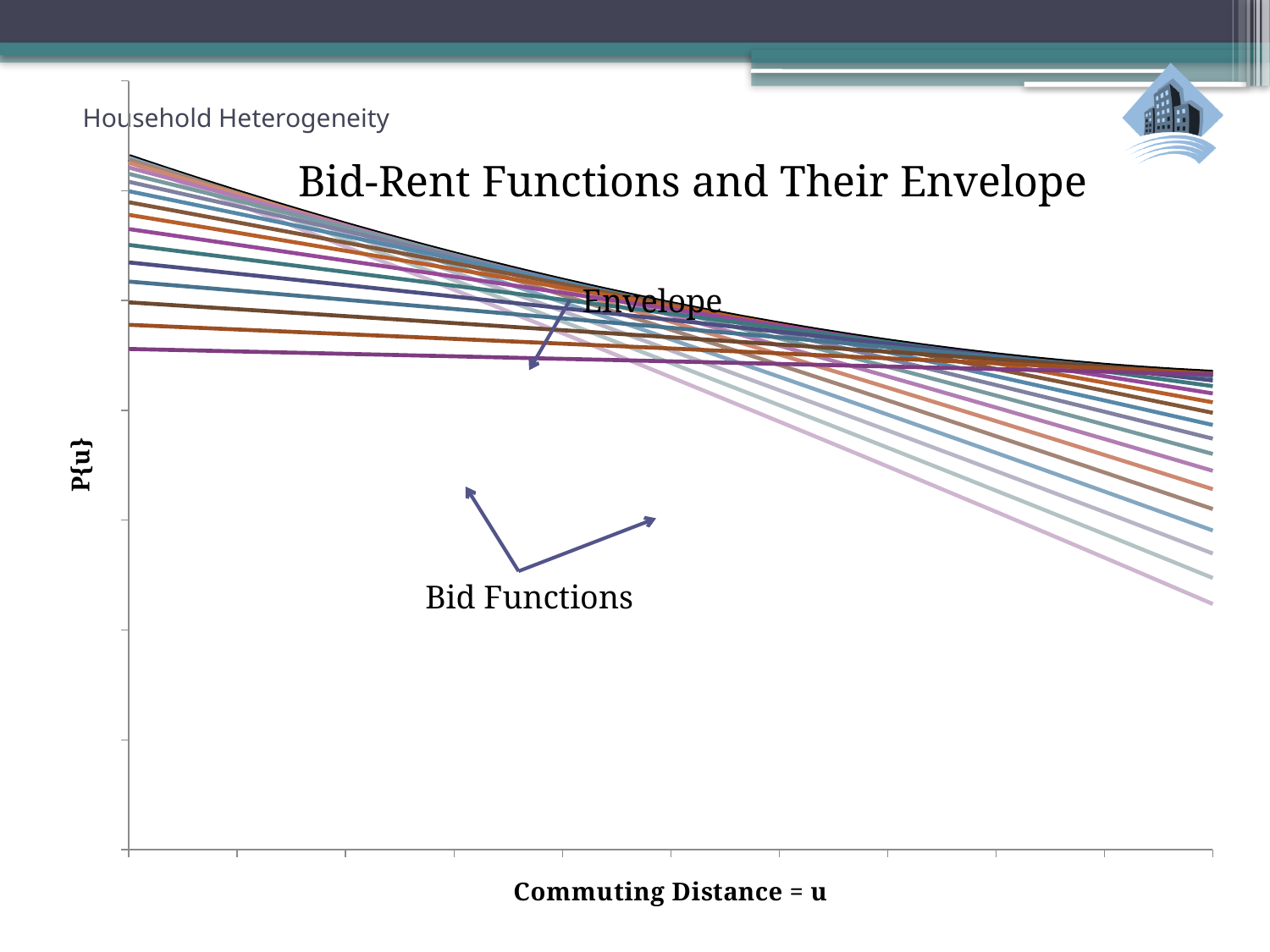
What is the title of the chart? Bid-Rent Functions and Their Envelope Does the envelope curve rise or fall as you move from left to right along the x axis? fall Do the bid functions rise or fall as commuting distance u increases along the x axis? fall What kind of chart is shown on the slide? line chart What is the label on the x axis of the chart? Commuting Distance = u